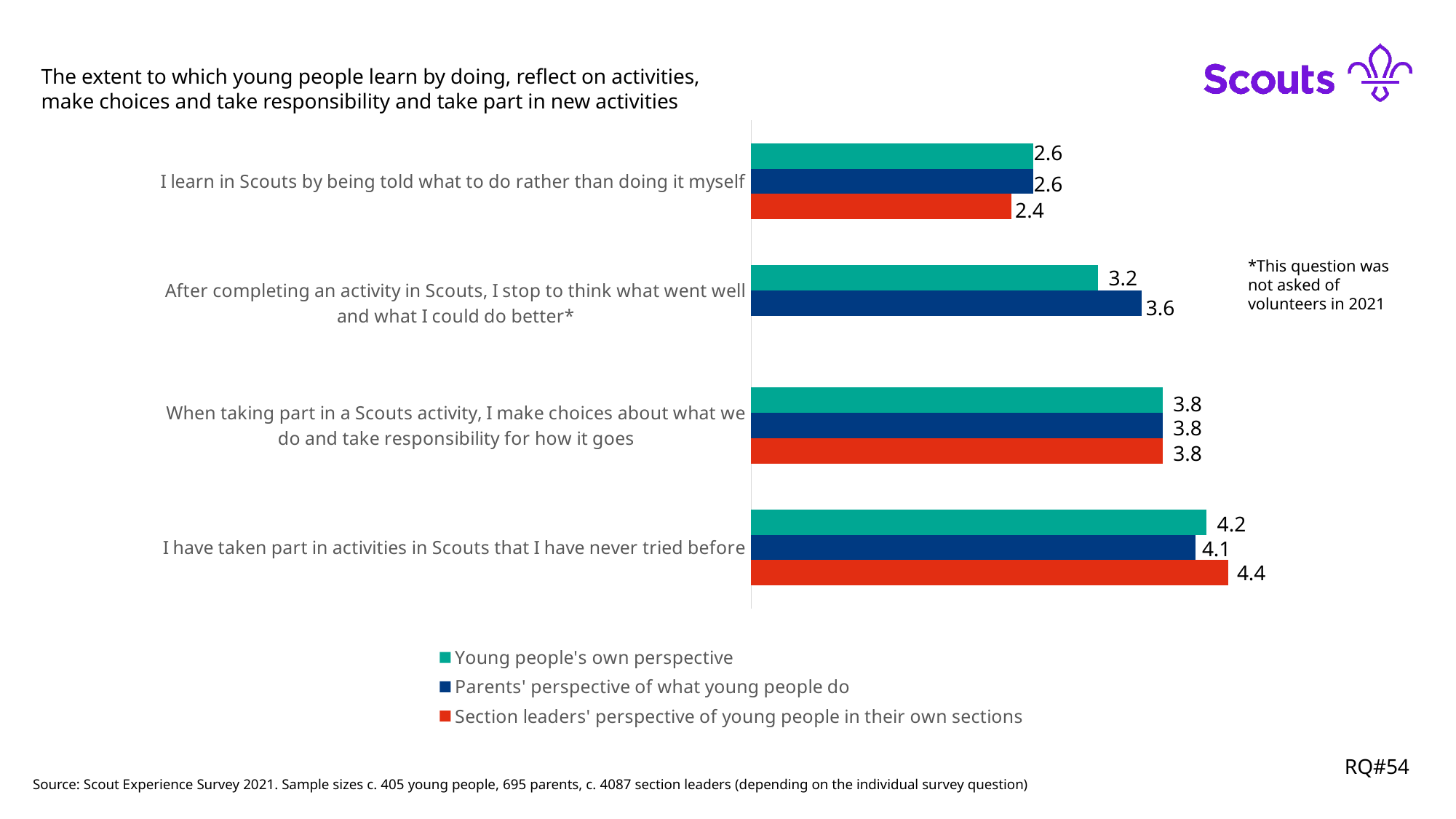
For "After completing an activity in Scouts, I stop to think what went well and what I could do better", which is larger: Young people's own perspective or Parents' perspective? Parents' perspective How many statements (categories) are shown on the chart? 4 What is the value for Section leaders' perspective for "I learn in Scouts by being told what to do rather than doing it myself"? 2.4 What is the value for Young people's own perspective for "I have taken part in activities in Scouts that I have never tried before"? 4.2 Which statement has no bar for Section leaders' perspective? After completing an activity in Scouts, I stop to think what went well and what I could do better Which statement has the highest value for Section leaders' perspective? I have taken part in activities in Scouts that I have never tried before What kind of chart is shown on the slide? Bar chart What is the value for Parents' perspective for "After completing an activity in Scouts, I stop to think what went well and what I could do better"? 3.6 What colour are the bars for Parents' perspective of what young people do? Dark blue What is the difference between the Section leaders' value and the Parents' value for "I have taken part in activities in Scouts that I have never tried before"? 0.3 Which statement has the lowest value for Young people's own perspective? I learn in Scouts by being told what to do rather than doing it myself How many series does the legend list? 3